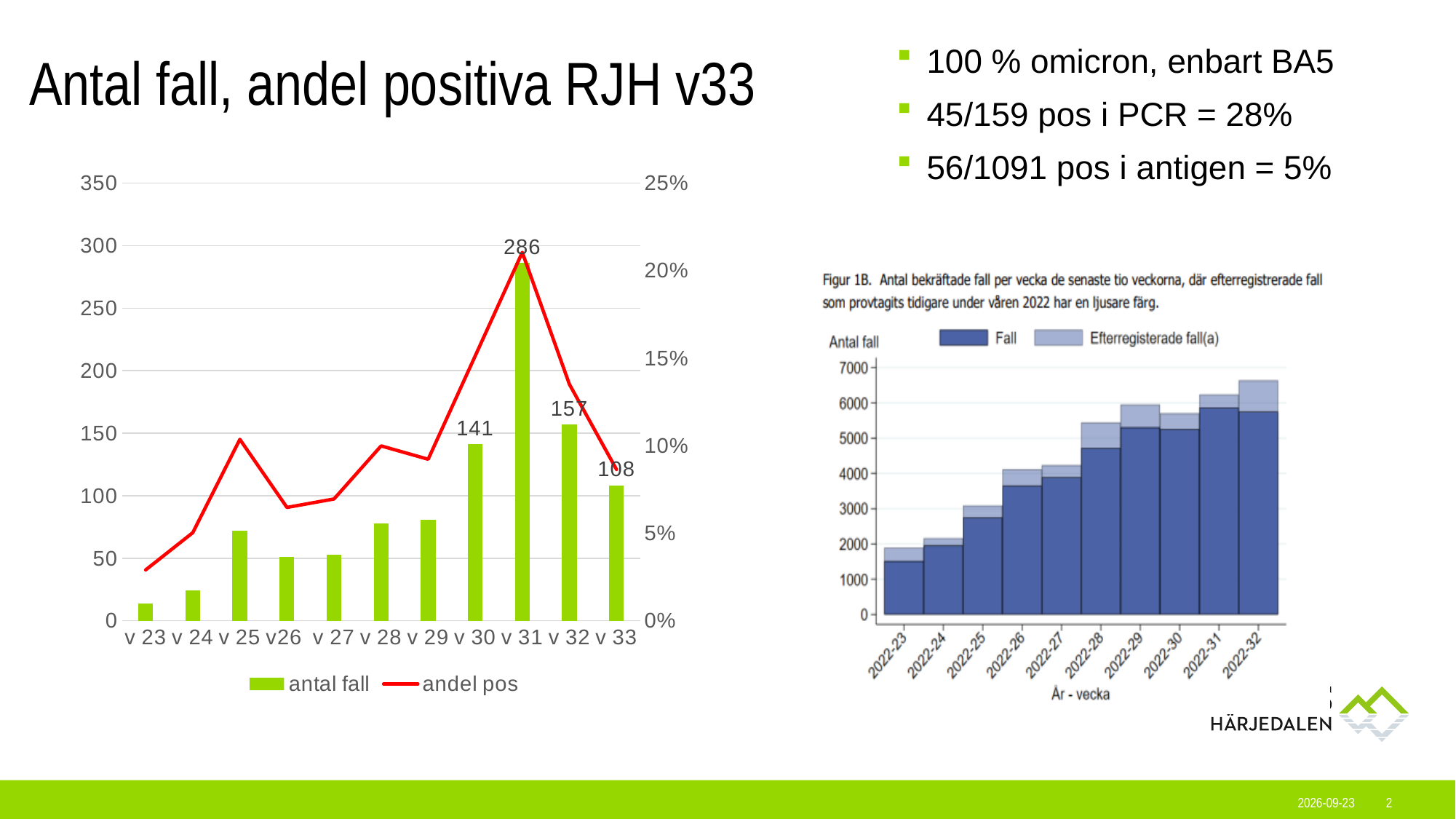
In the left chart 'Antal fall, andel positiva RJH v33', how many weeks are shown on the x axis? 11 In the left chart 'Antal fall, andel positiva RJH v33', what is the difference in antal fall between v 31 and v 32? 129 In the right chart 'Figur 1B', do the total bar heights generally rise or fall from 2022-23 to 2022-32? rise In the left chart 'Antal fall, andel positiva RJH v33', which week has the highest antal fall? v 31 In the left chart 'Antal fall, andel positiva RJH v33', what is the value of antal fall for v 32? 157 In the left chart 'Antal fall, andel positiva RJH v33', which week has the lowest antal fall? v 23 In the left chart 'Antal fall, andel positiva RJH v33', what is the value of antal fall for v 31? 286 In the right chart 'Figur 1B', how many weeks are shown on the x axis? 10 In the right chart 'Figur 1B', how many series does the legend list? 2 In the left chart 'Antal fall, andel positiva RJH v33', is the antal fall value for v 25 greater or less than 50? greater In the left chart 'Antal fall, andel positiva RJH v33', what is the difference in antal fall between v 32 and v 33? 49 In the left chart 'Antal fall, andel positiva RJH v33', how many series does the legend list? 2